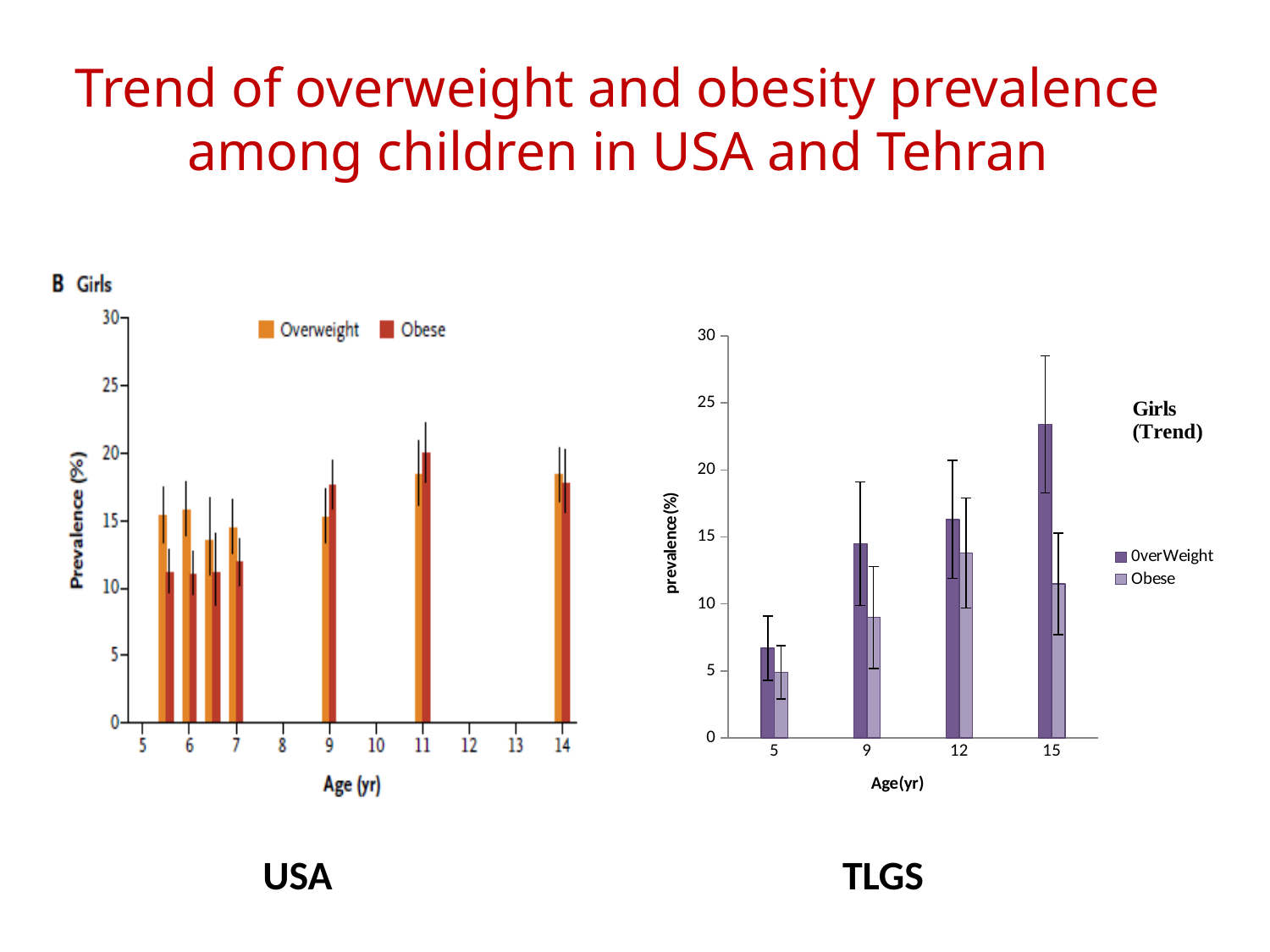
In the USA chart, is the Overweight value at age 11 greater or less than 15? greater In the TLGS chart, at age 15, which is larger: Overweight or Obese? Overweight How many age groups are shown on the x axis of the TLGS chart? 4 In the TLGS chart, at which age is the Obese prevalence highest? 12 In the TLGS chart, is the Obese value at age 5 greater or less than 10? less In the TLGS chart, at which age is the Overweight prevalence lowest? 5 In the TLGS chart, at which age is the Overweight prevalence highest? 15 How many series does the legend of the TLGS chart list? 2 In the TLGS chart, does the Overweight prevalence rise or fall as age increases from 5 to 15? rises What kind of chart is the TLGS chart on the right? bar chart In the USA chart, at age 6, which is larger: Overweight or Obese? Overweight In the TLGS chart, is the Overweight value at age 15 greater or less than 20? greater